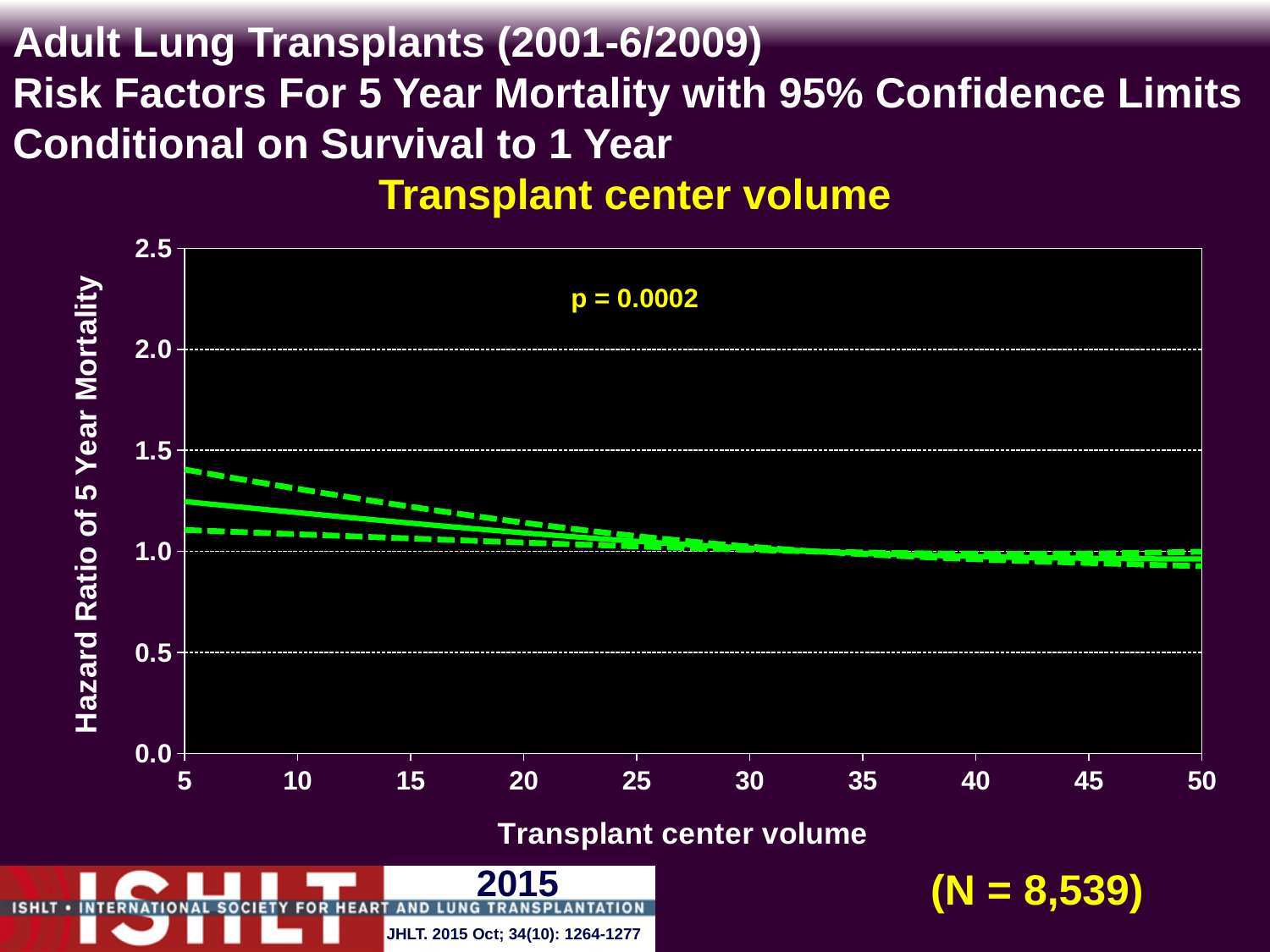
Is the hazard ratio of 5 year mortality at a transplant center volume of 30 greater or less than 1.5? less Is the hazard ratio of 5 year mortality higher at a transplant center volume of 5 or at a volume of 40? 5 What p-value is printed on the chart? p = 0.0002 What kind of chart is shown on the slide? line chart What is the label of the y axis of the chart? Hazard Ratio of 5 Year Mortality Is the upper 95% confidence limit at a transplant center volume of 5 greater or less than 1.5? less How many lines are plotted on the chart? 3 Is the hazard ratio of 5 year mortality at a transplant center volume of 5 greater or less than 1.0? greater How many tick labels are shown on the x axis of the chart? 10 Does the hazard ratio of 5 year mortality rise or fall as transplant center volume increases from 5 to 50? fall